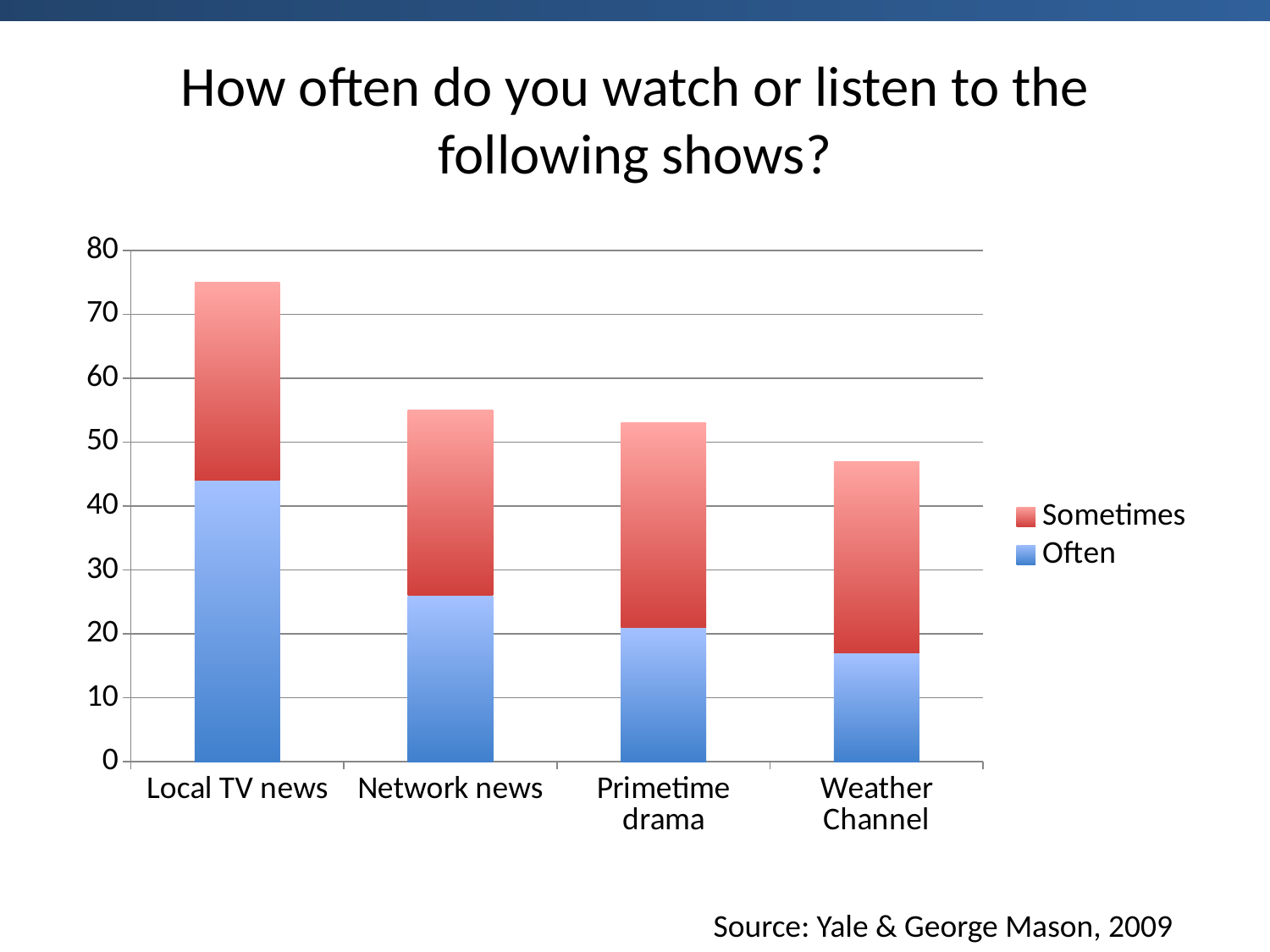
What kind of chart is shown on the slide? stacked bar chart Which category has the shortest stacked bar overall? Weather Channel Which is larger, the 'Often' value for Local TV news or the 'Often' value for Network news? Local TV news How many categories are shown on the x axis? 4 Which category has the tallest stacked bar overall? Local TV news Is the 'Often' value for Network news greater or less than 20? greater Is the total stacked value for Local TV news greater or less than 70? greater Is the 'Often' value for Local TV news greater or less than 40? greater Do the total stacked values rise or fall moving from left to right across the categories? fall How many series does the legend list? 2